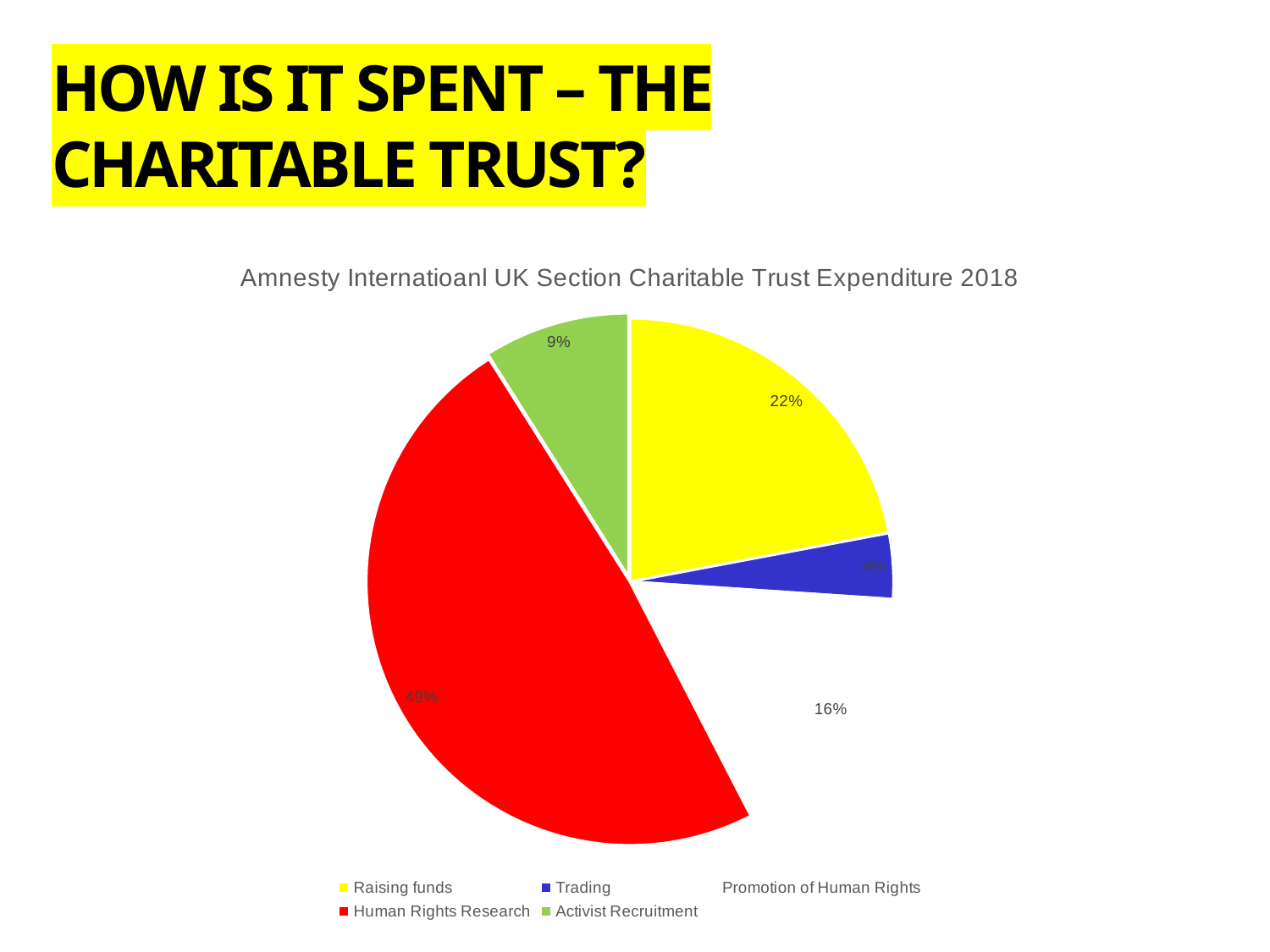
Which category has the smallest share of expenditure? Trading Which category has the largest share of expenditure? Human Rights Research How many categories does the legend list? 5 What type of chart is shown on the slide? Pie chart What percentage of expenditure goes to Human Rights Research? 49% What is the title of the chart? Amnesty Internatioanl UK Section Charitable Trust Expenditure 2018 Which is larger, Promotion of Human Rights or Activist Recruitment? Promotion of Human Rights What percentage of expenditure goes to Activist Recruitment? 9% How many percentage points larger is Human Rights Research than Raising funds? 27 What percentage of expenditure goes to Trading? 4% What percentage of expenditure goes to Promotion of Human Rights? 16% What percentage of expenditure goes to Raising funds? 22%